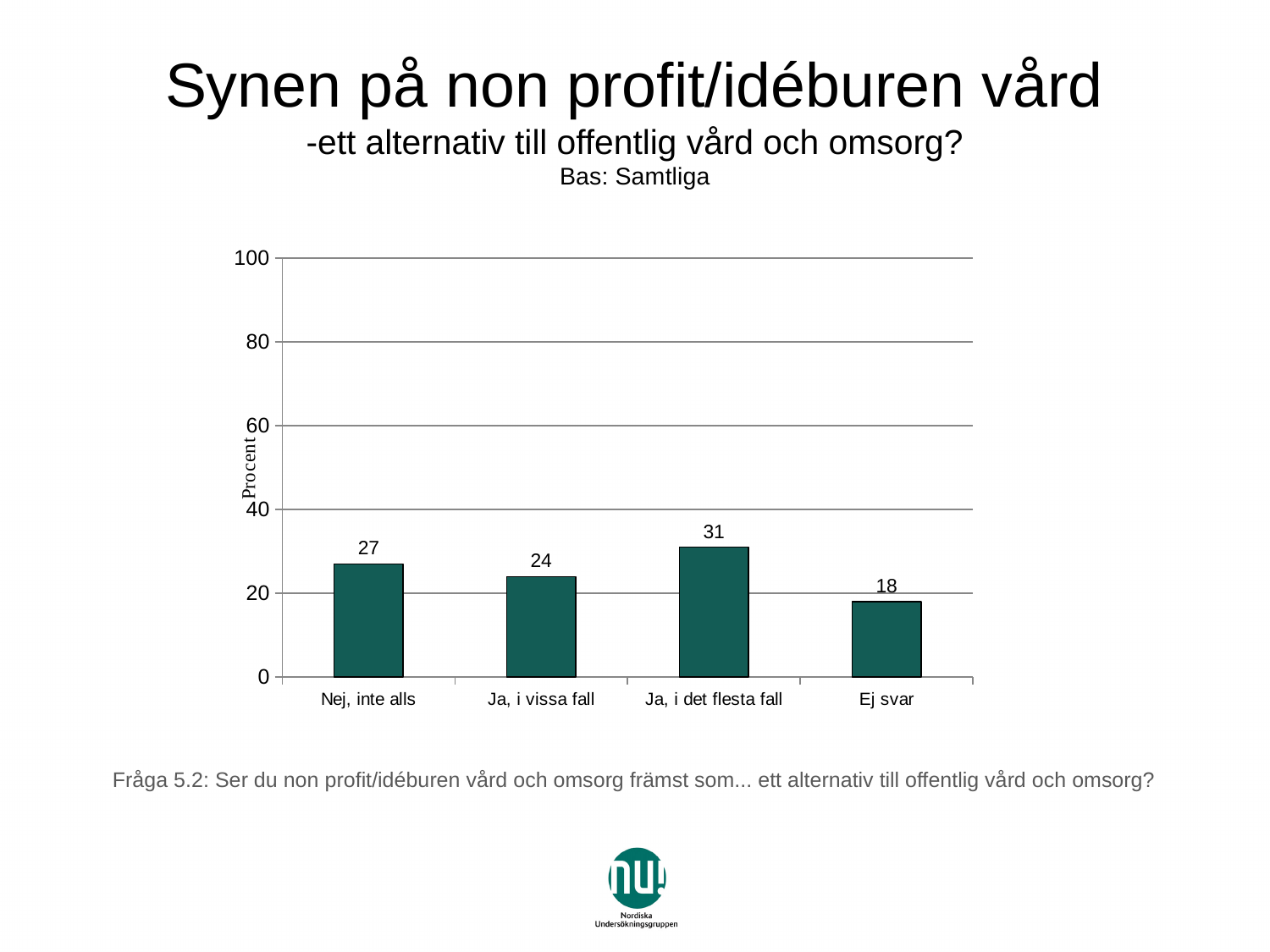
How many categories are shown on the x axis? 4 What is the value for "Nej, inte alls"? 27 What is the value for "Ja, i det flesta fall"? 31 What kind of chart is shown on the slide? bar chart Is the value for "Ja, i det flesta fall" greater or less than 40? less What is the label of the y axis? Procent Which category has the lowest value? Ej svar What is the value for "Ja, i vissa fall"? 24 What is the difference between the values for "Ja, i det flesta fall" and "Ej svar"? 13 Which is larger, the value for "Nej, inte alls" or the value for "Ja, i vissa fall"? Nej, inte alls Which category has the highest value? Ja, i det flesta fall What is the value for "Ej svar"? 18